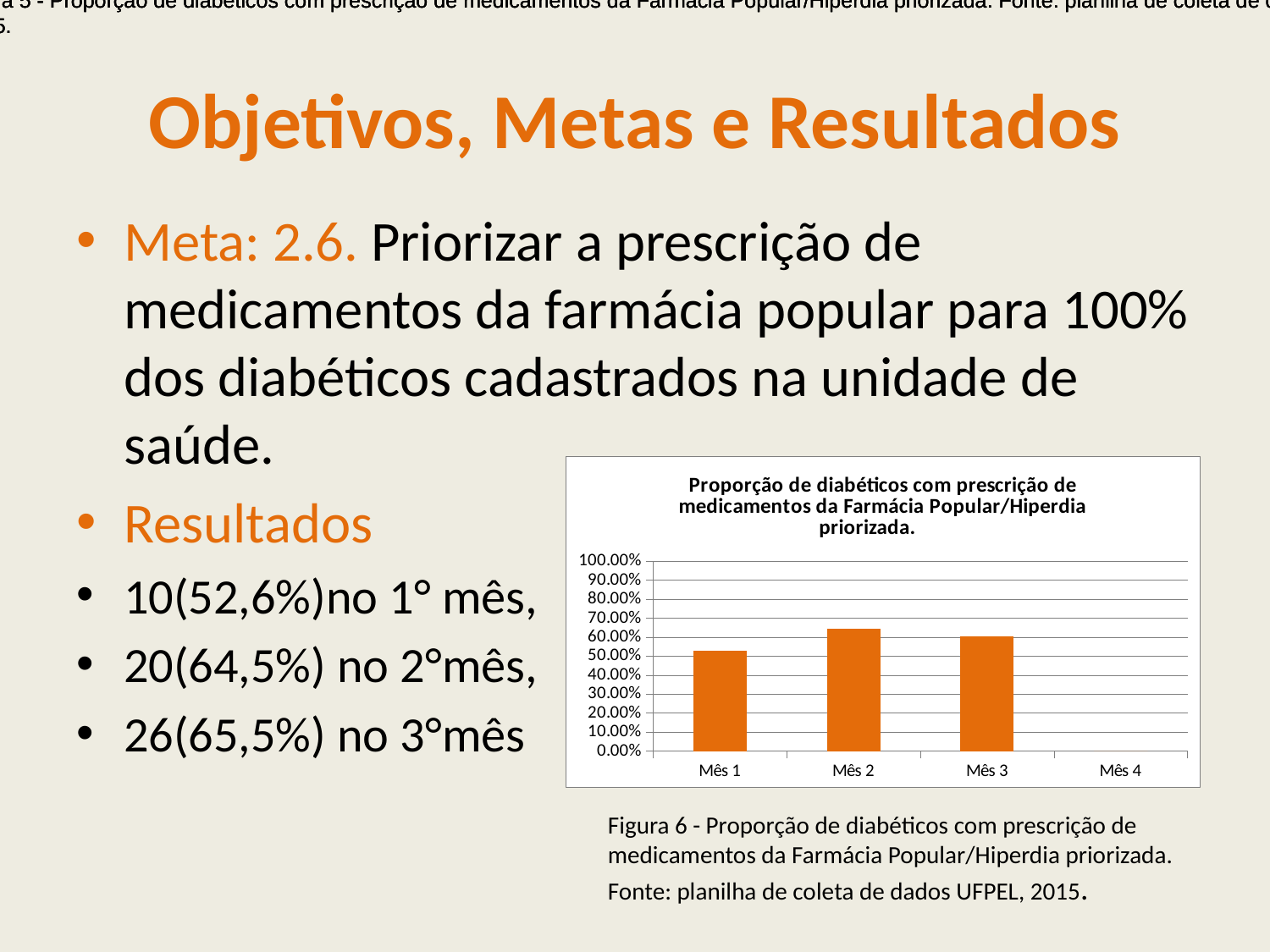
Is the value for Mês 2 greater or less than 60.00%? greater What is the highest value shown on the y axis of the chart? 100.00% What kind of chart is shown on the slide? bar chart Which month category on the x axis has no bar plotted? Mês 4 Is the value for Mês 2 greater or less than 70.00%? less How many month categories are shown on the x axis of the chart? 4 Is the value for Mês 1 greater or less than 60.00%? less Does the value rise or fall from Mês 1 to Mês 2? rise Which is larger, the value for Mês 1 or the value for Mês 2? Mês 2 Which month has the lowest bar in the chart among the months with a plotted bar? Mês 1